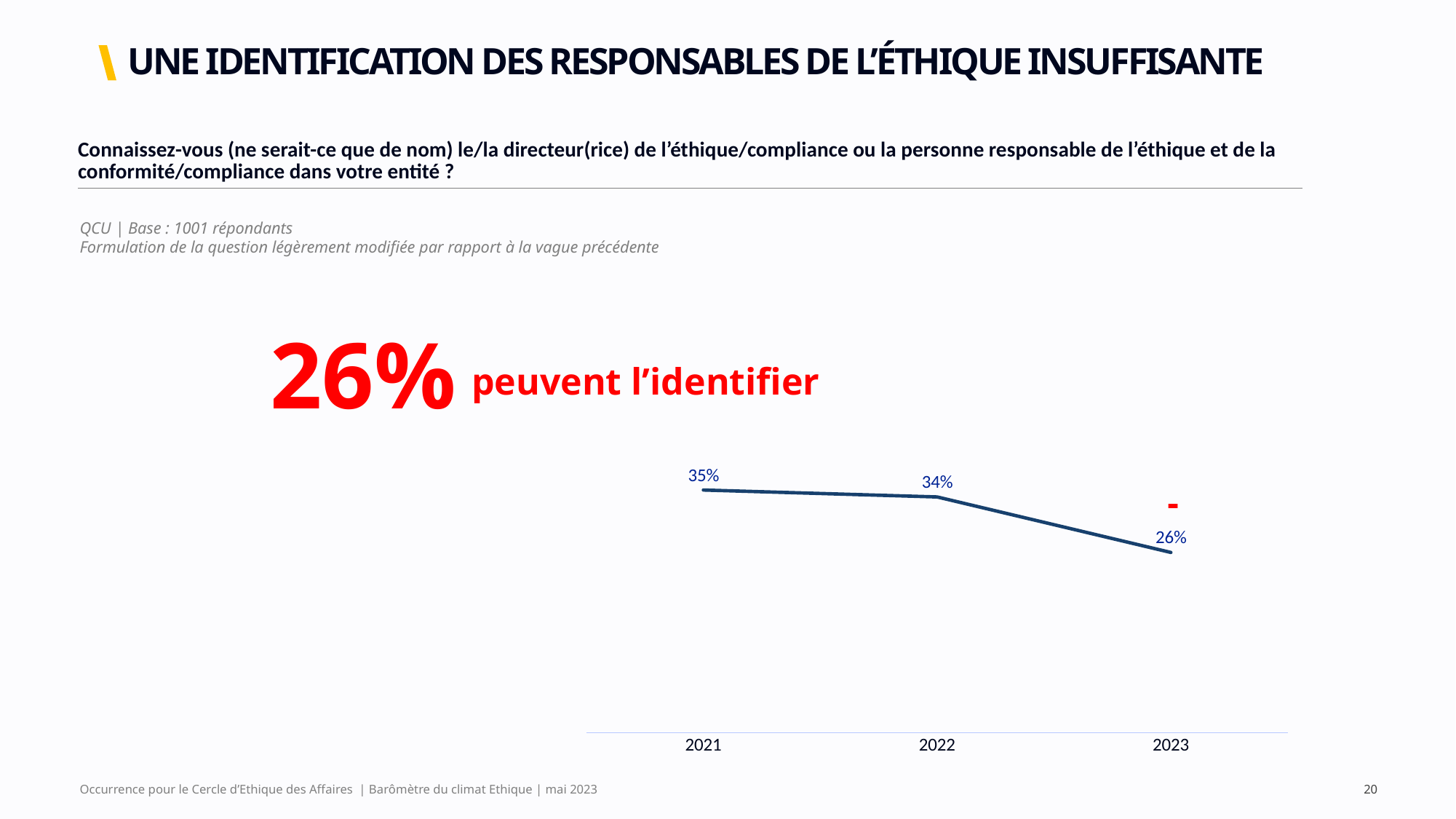
Which year has the lowest value? 2023 What kind of chart is shown on the slide? Line chart What is the value for 2023? 26% Do the values rise or fall from 2021 to 2023? Fall What is the value for 2021? 35% What is the large red percentage highlighted on the slide? 26% Which is larger, the value for 2021 or the value for 2022? 2021 Which year has the highest value? 2021 How many data points are plotted on the chart? 3 What is the value for 2022? 34% What is the difference between the values for 2022 and 2023? 8 percentage points What is the difference between the values for 2021 and 2023? 9 percentage points